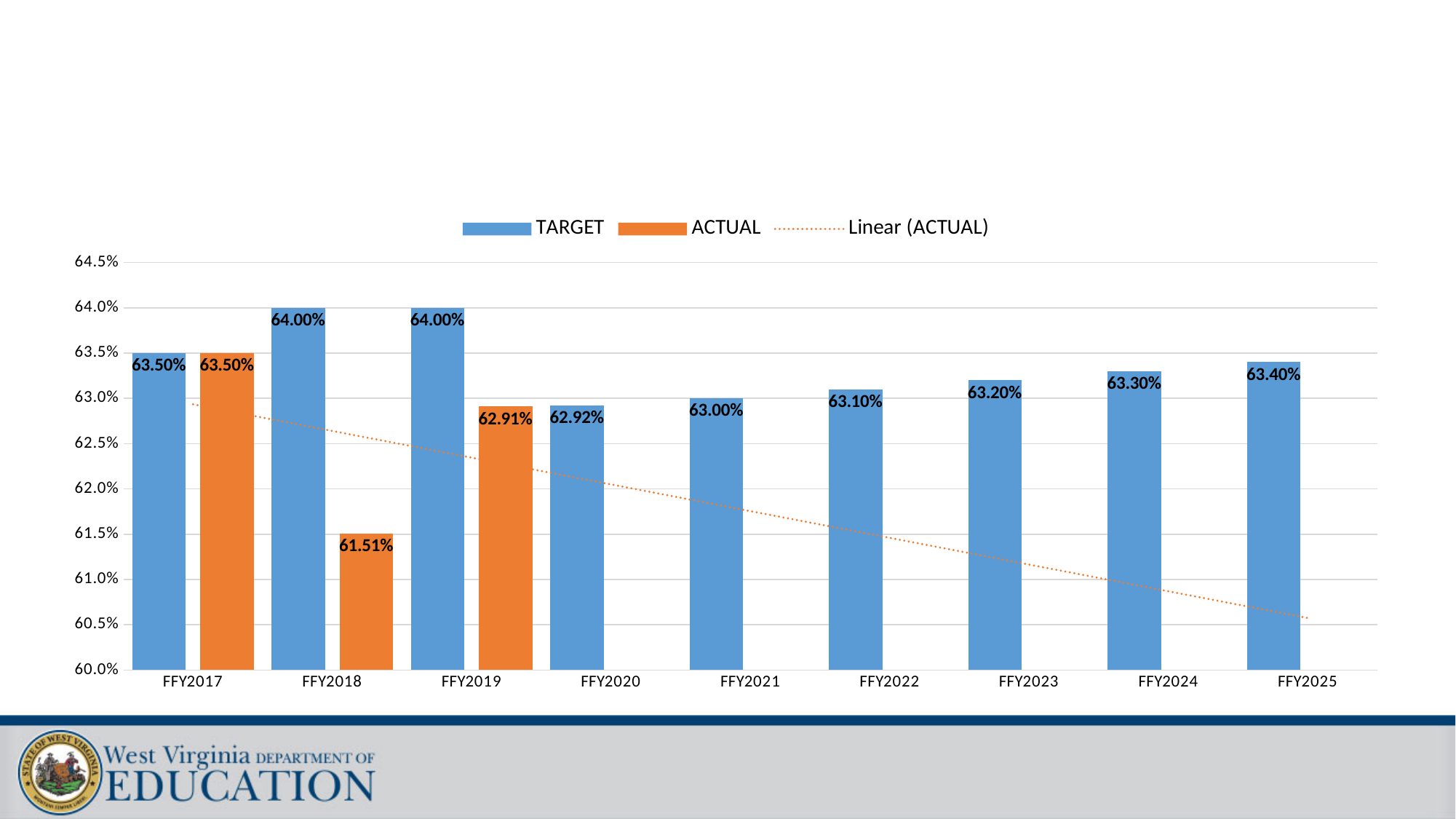
Which year has the lowest ACTUAL value? FFY2018 What is the difference between the TARGET and ACTUAL values for FFY2018? 2.49% How many entries does the legend list? 3 What is the ACTUAL value for FFY2018? 61.51% What is the TARGET value for FFY2025? 63.40% Which year has the lowest TARGET value? FFY2020 Is the ACTUAL value for FFY2018 greater or less than 62.0%? less What is the TARGET value for FFY2021? 63.00% How many years are shown on the x axis? 9 What is the ACTUAL value for FFY2019? 62.91% Which is larger, the ACTUAL value for FFY2018 or the ACTUAL value for FFY2019? FFY2019 Do the TARGET values rise or fall from FFY2020 to FFY2025? rise